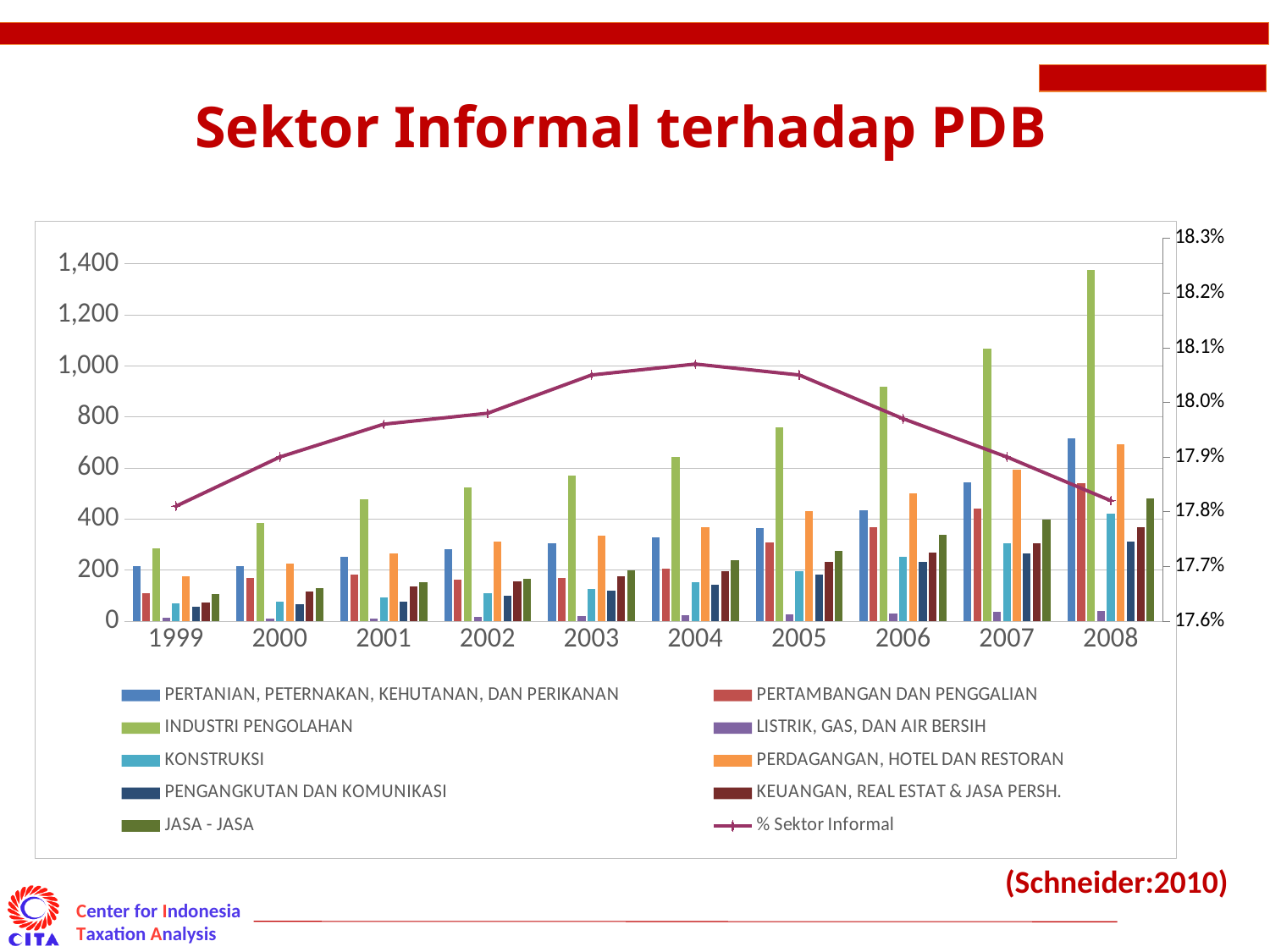
In which year is the INDUSTRI PENGOLAHAN bar the highest? 2008 Is the % Sektor Informal value for 1999 greater or less than 17.9%? less Is the INDUSTRI PENGOLAHAN value for 2008 greater or less than 1,200? greater In 2005, which is larger: INDUSTRI PENGOLAHAN or KONSTRUKSI? INDUSTRI PENGOLAHAN Does the % Sektor Informal line rise or fall from 2004 to 2008? falls What kind of chart is shown on the slide? A bar chart combined with a line Is the PERTANIAN, PETERNAKAN, KEHUTANAN, DAN PERIKANAN value for 2008 greater or less than 600? greater In which year does the % Sektor Informal line reach its highest point? 2004 How many years are shown along the x axis of the chart? 10 What is the title of the slide's chart? Sektor Informal terhadap PDB How many series does the chart's legend list? 10